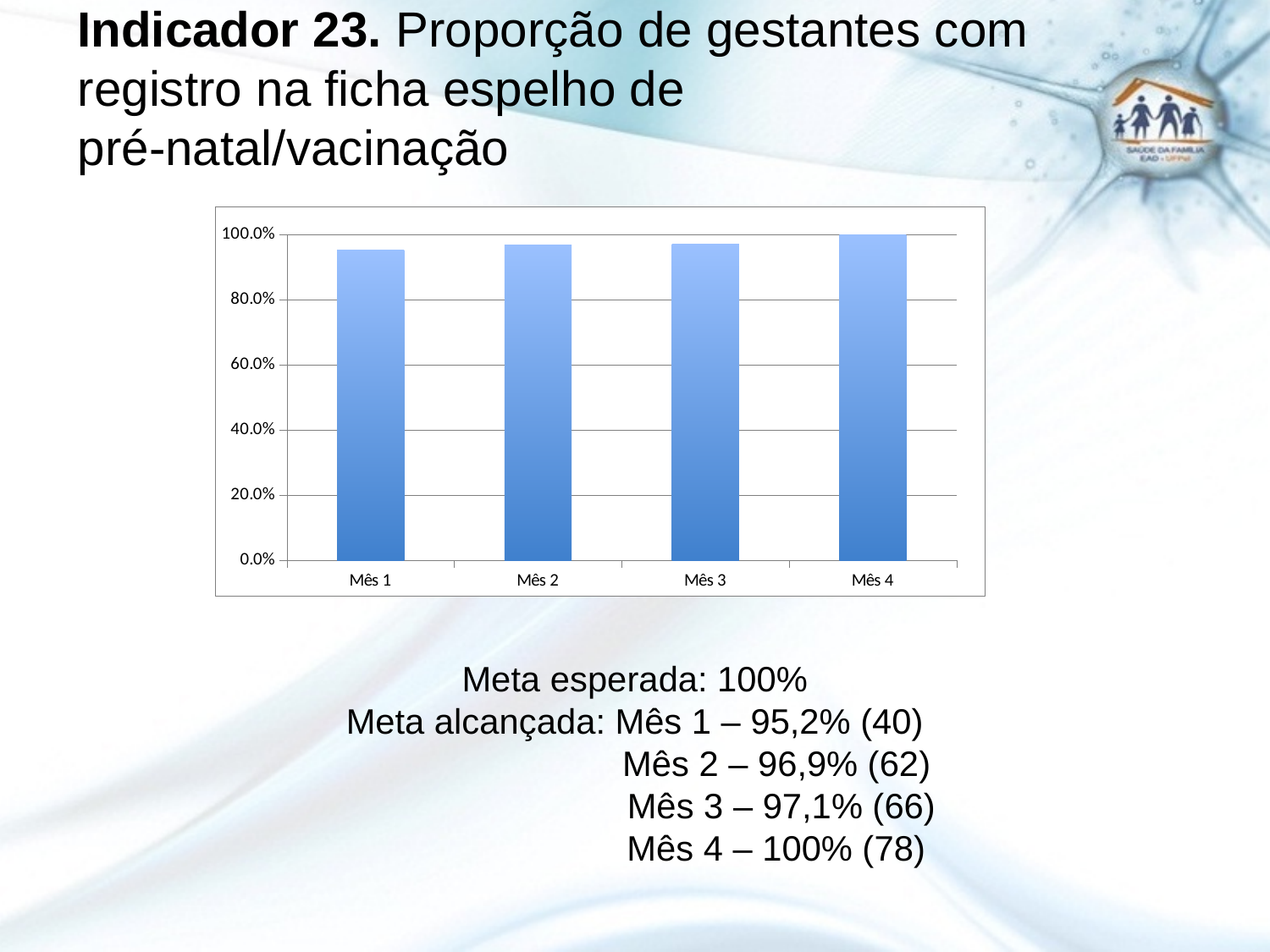
What is the value for Mês 3? 97,1% What is the value for Mês 4? 100% What is the difference between the value for Mês 4 and the value for Mês 1? 4,8% What is the value for Mês 1? 95,2% How many bars (months) are plotted in the chart? 4 Which is larger, the value for Mês 1 or the value for Mês 4? Mês 4 What kind of chart is shown on the slide? bar chart Is the value for Mês 1 greater or less than 80.0%? greater Which month has the highest value in the chart? Mês 4 Which month has the lowest value in the chart? Mês 1 Do the values rise or fall from Mês 1 to Mês 4? rise What is the 'Meta esperada' stated below the chart? 100%